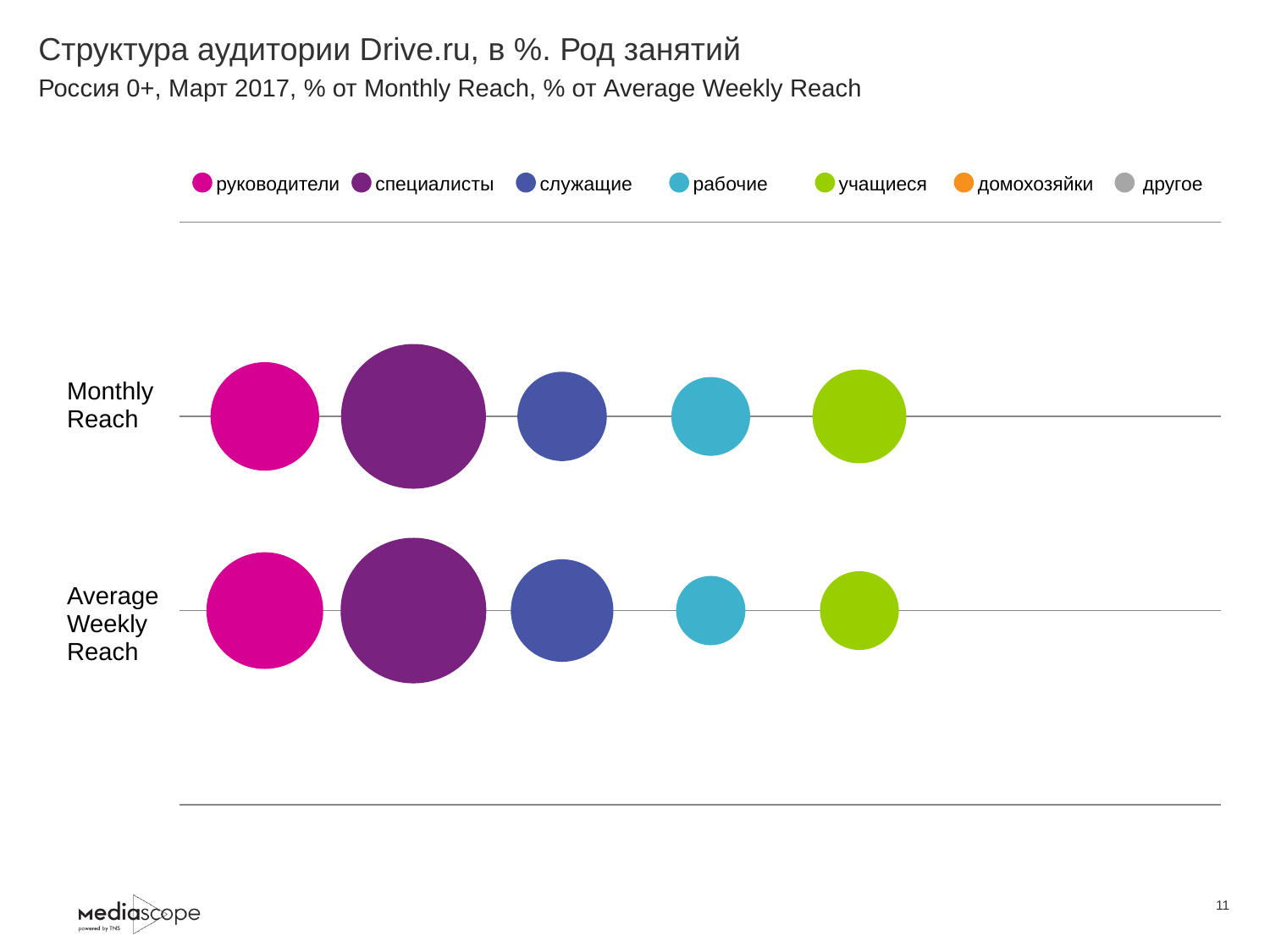
Which visible occupation group has the smallest bubble in the Average Weekly Reach row? рабочие Which occupation group has the largest bubble in the Average Weekly Reach row? специалисты How many series does the legend list? 7 Which occupation group has the largest bubble in the Monthly Reach row? специалисты Which legend entry is shown in orange? домохозяйки How many rows (reach categories) are plotted on the chart? 2 What are the two row labels on the left of the chart? Monthly Reach and Average Weekly Reach What kind of chart is shown on the slide? bubble chart What is the title of the chart on the slide? Структура аудитории Drive.ru, в %. Род занятий In the Average Weekly Reach row, which bubble is larger: служащие or рабочие? служащие In the Monthly Reach row, which bubble is larger: учащиеся or рабочие? учащиеся In the Monthly Reach row, which bubble is larger: специалисты or руководители? специалисты